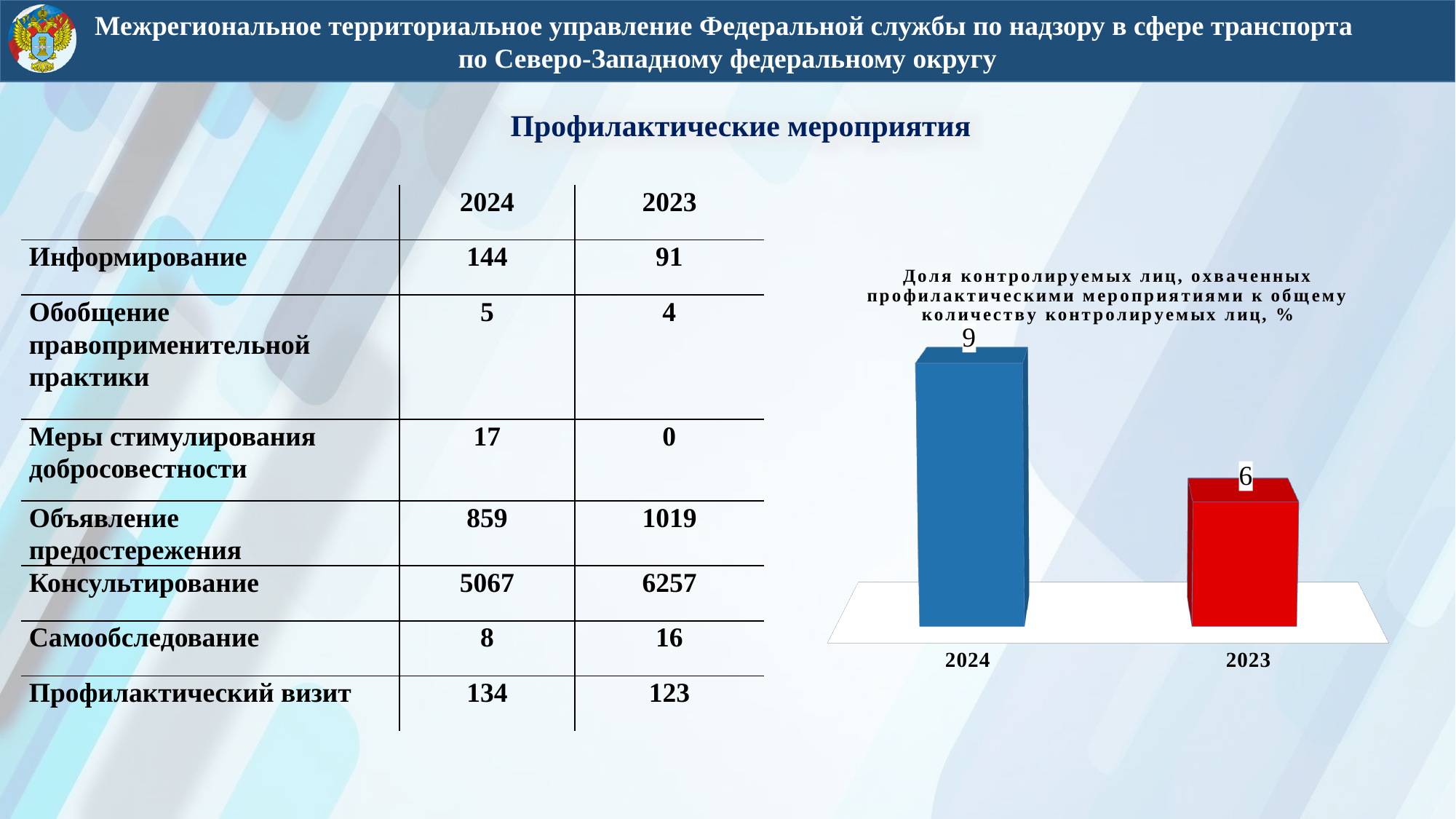
What is the value for 2024 in the chart? 9 Which year has the lowest value in the chart? 2023 Do the values in the chart rise or fall from left to right along the x axis? Fall What colour is the bar for 2023 in the chart? Red How many bars are shown in the chart? 2 Which year has the highest value in the chart? 2024 What is the title of the chart? Доля контролируемых лиц, охваченных профилактическими мероприятиями к общему количеству контролируемых лиц, % Which is larger in the chart, the value for 2024 or the value for 2023? 2024 What is the value for 2023 in the chart? 6 What is the difference between the values for 2024 and 2023 in the chart? 3 What kind of chart is shown on the slide? Bar chart